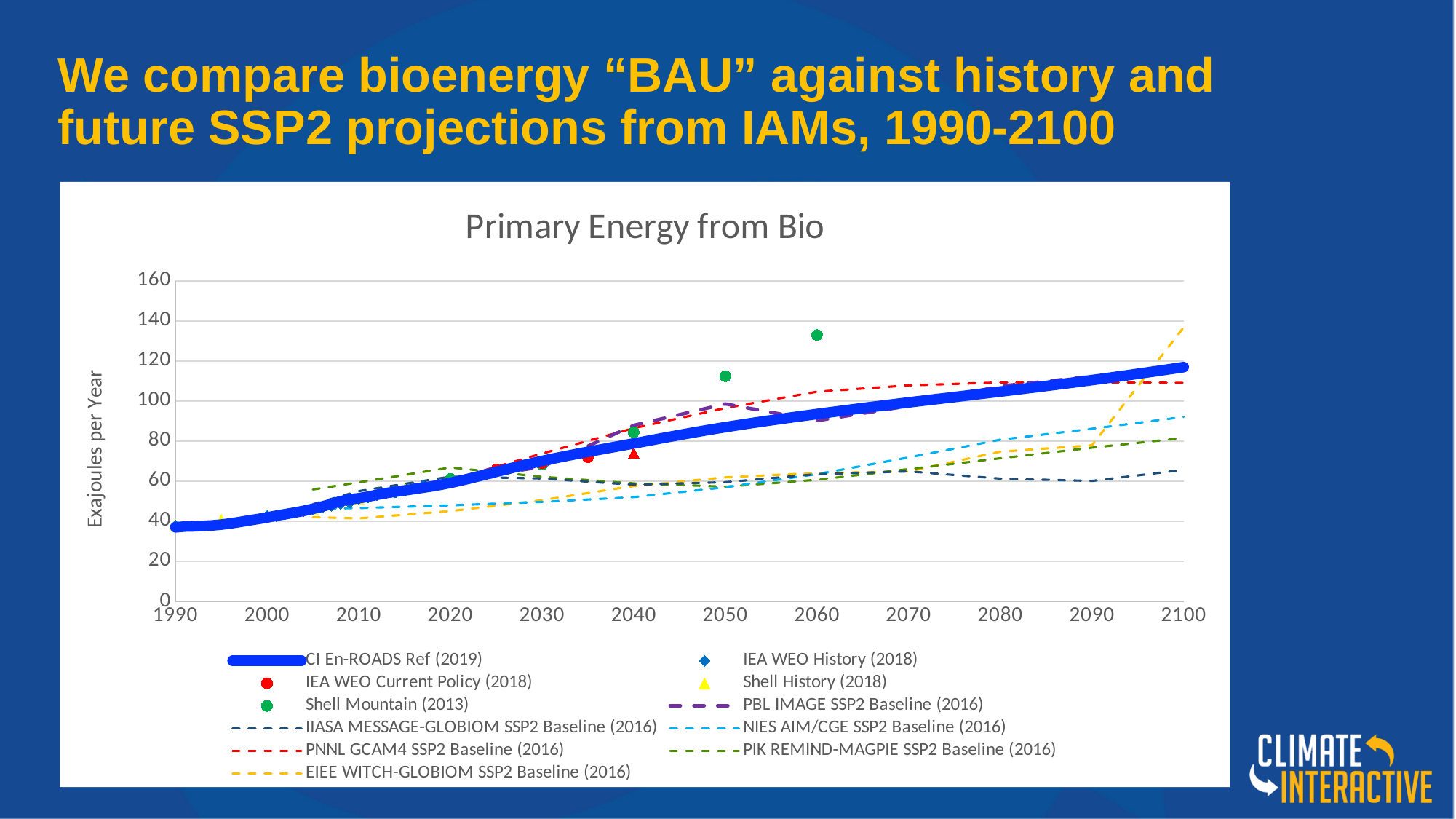
What kind of chart is shown on the slide? line chart Is the value of the CI En-ROADS Ref (2019) series in 1990 greater or less than 40? less Is the Shell Mountain (2013) point at 2060 greater or less than 120? greater Is the value of the IIASA MESSAGE-GLOBIOM SSP2 Baseline (2016) series in 2100 greater or less than 80? less How many series does the chart's legend list? 11 What is the title of the chart? Primary Energy from Bio In 2100, which is higher: the EIEE WITCH-GLOBIOM SSP2 Baseline (2016) series or the IIASA MESSAGE-GLOBIOM SSP2 Baseline (2016) series? EIEE WITCH-GLOBIOM SSP2 Baseline (2016) What is the label on the vertical axis of the chart? Exajoules per Year Does the CI En-ROADS Ref (2019) series rise or fall from 1990 to 2100? rise Which series reaches the highest value in 2100? EIEE WITCH-GLOBIOM SSP2 Baseline (2016)